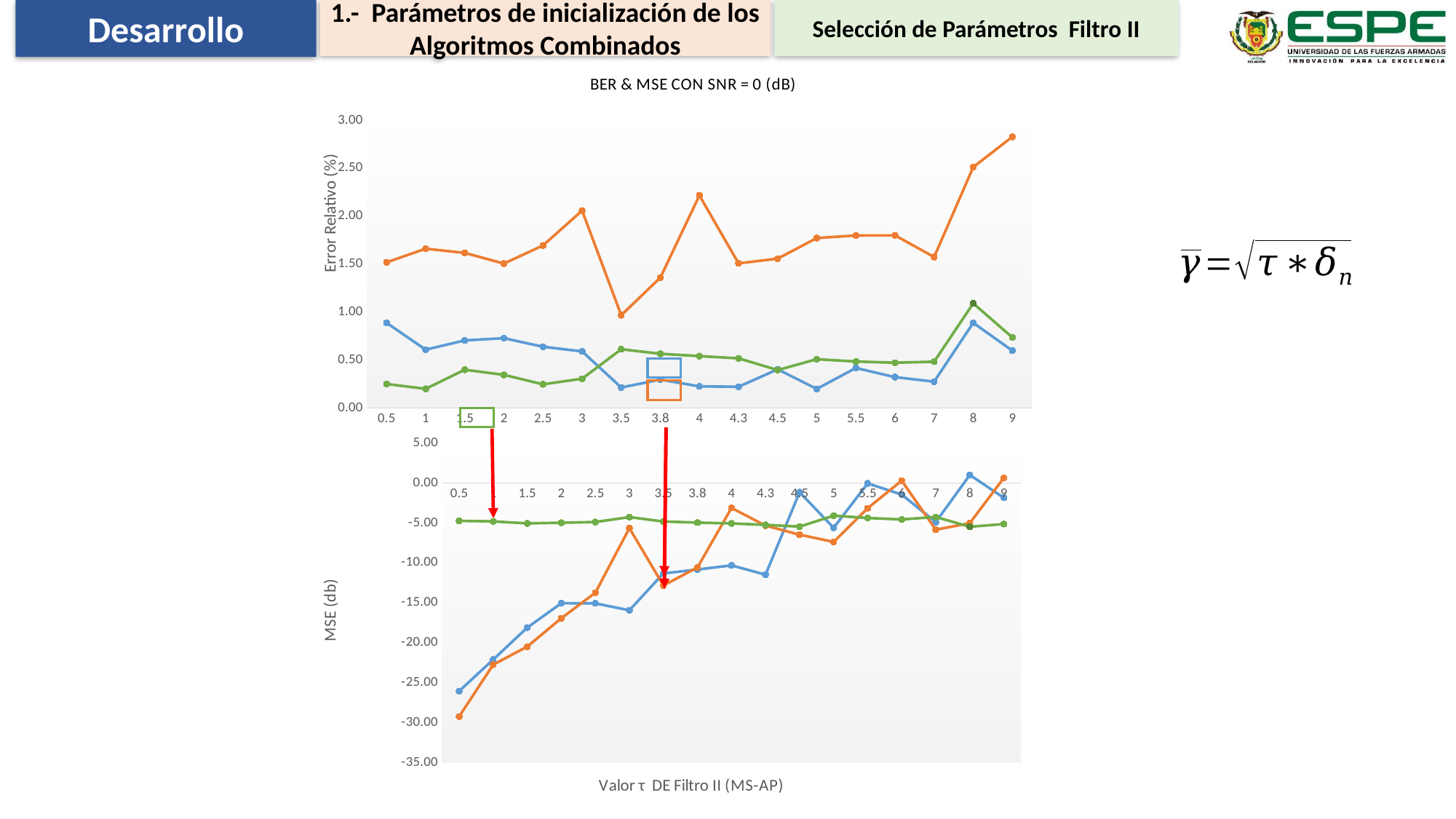
In the top chart, is the value of the orange series at x = 9 greater or less than 2.50? greater In the top chart, how many x-axis categories (τ values) are plotted? 17 In the top chart, at which x-axis value does the orange series reach its lowest point? 3.5 In the bottom chart, does the blue series overall rise or fall as the x-axis value increases from 0.5 to 9? rise In the top chart, at which x-axis value does the orange series reach its highest point? 9 What kind of chart is the top chart titled 'BER & MSE CON SNR = 0 (dB)'? line chart What is the x-axis title of the bottom chart? Valor τ DE Filtro II (MS-AP) What kind of chart is the bottom chart with the y-axis 'MSE (db)'? line chart In the bottom chart, at which x-axis value does the orange series reach its lowest point? 0.5 In the top chart, at x = 0.5, which series has the larger value, the orange series or the blue series? orange In the bottom chart, is the value of the orange series at x = 0.5 greater or less than -25.00? less